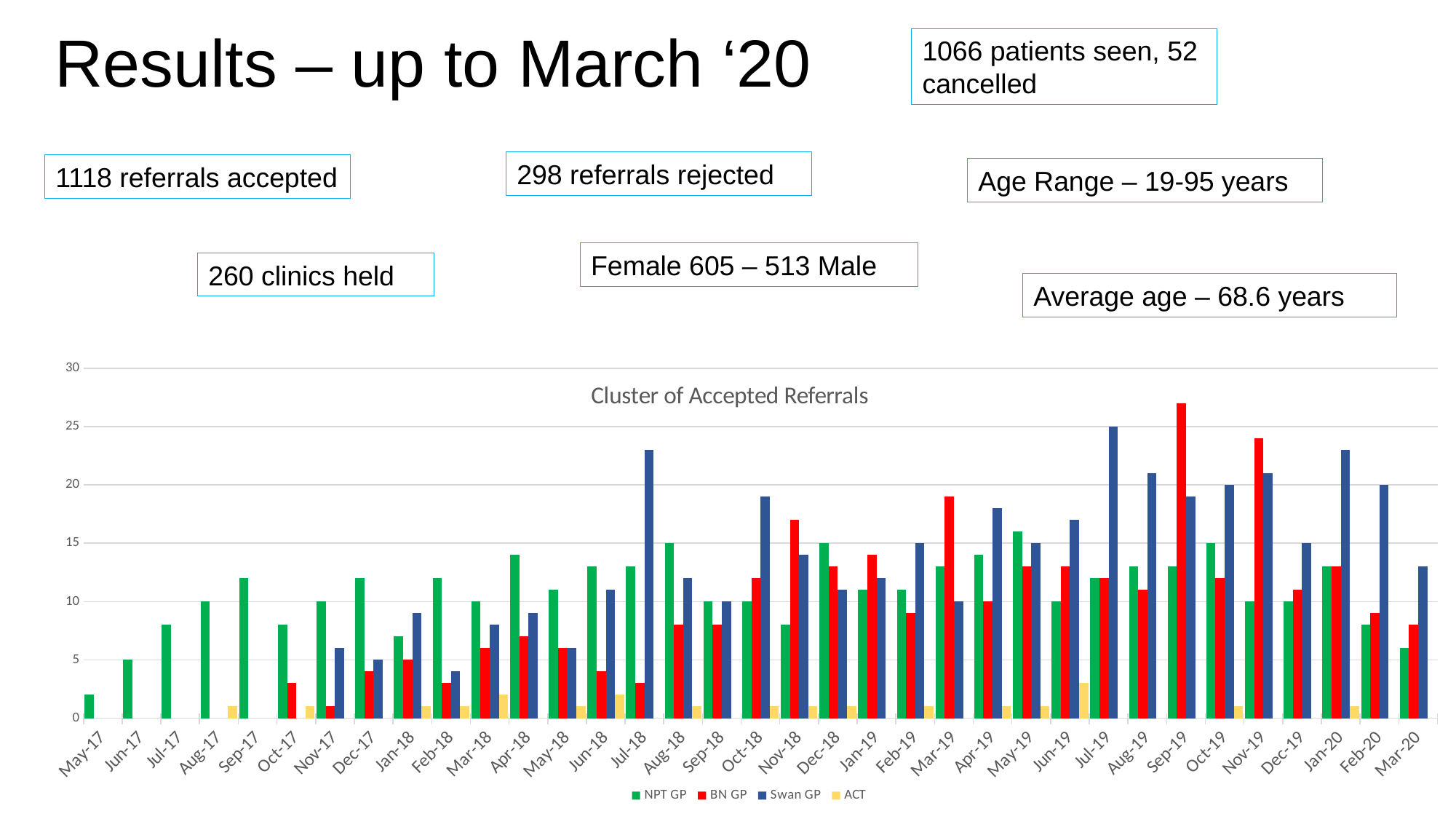
What is the value for NPT GP in Jun-17? 5 Do the NPT GP values rise or fall from May-17 to Sep-17? rise In Jul-18, which is larger: NPT GP or Swan GP? Swan GP How many months are shown on the x axis of the chart? 35 Which series has the lowest values across the chart? ACT What is the title of the chart? Cluster of Accepted Referrals Is the value for NPT GP in Mar-20 greater or less than 10? less How many series does the chart legend list? 4 Which series has the highest bar in Sep-19? BN GP What type of chart is shown on the slide? bar chart Is the value for Swan GP in Jul-18 greater or less than 20? greater What is the value for Swan GP in Jul-19? 25